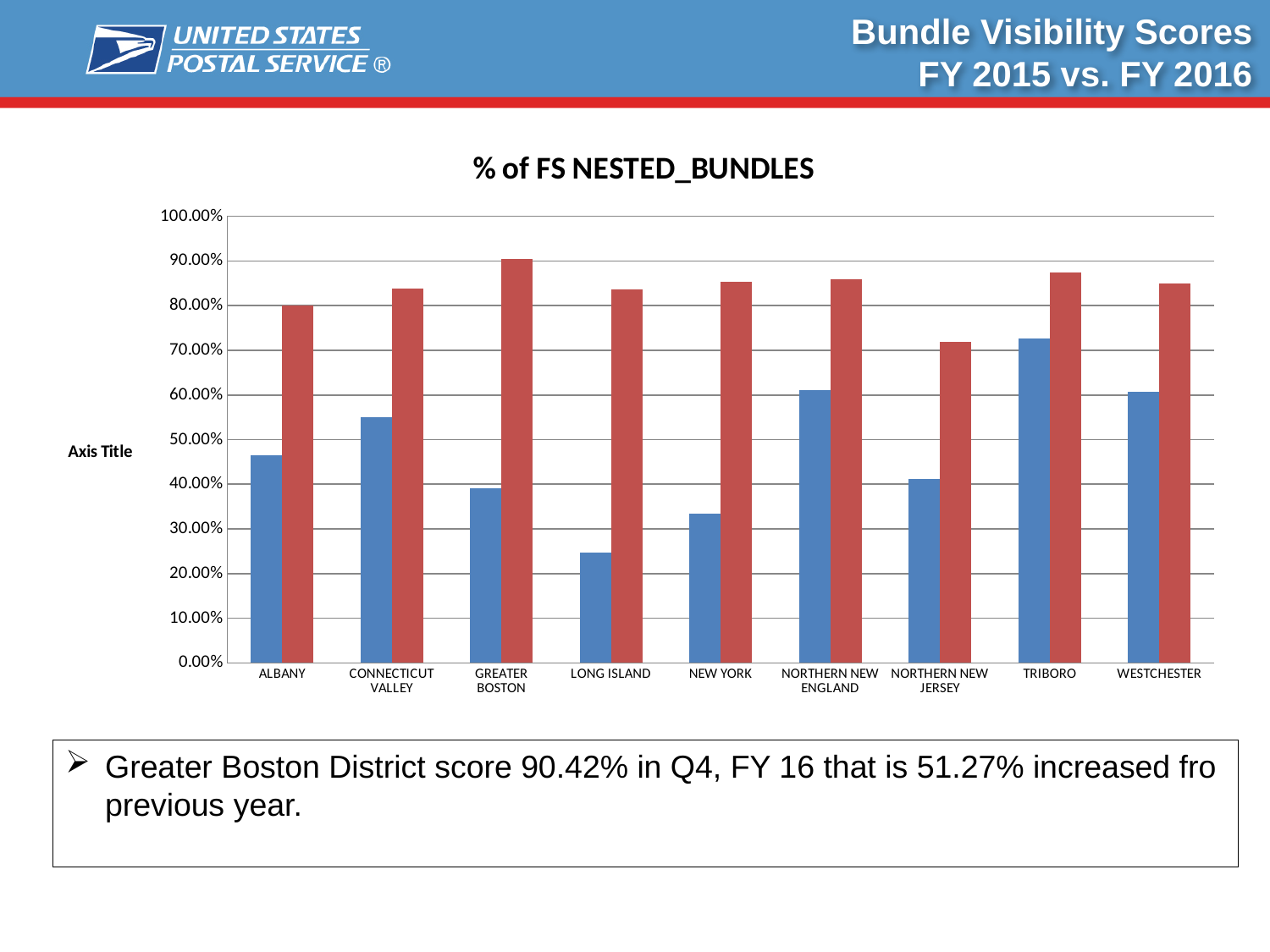
Is the blue bar for LONG ISLAND greater or less than 30.00%? less Which district has the tallest blue bar? TRIBORO Which district has the shortest blue bar? LONG ISLAND Which district has the tallest red bar? GREATER BOSTON How many districts are shown along the x axis of the chart? 9 What type of chart is shown on the slide? bar chart Is the blue bar for ALBANY greater or less than 50.00%? less Which is larger, the red bar for ALBANY or the red bar for NORTHERN NEW JERSEY? ALBANY What is the title of the chart? % of FS NESTED_BUNDLES Which is larger, the blue bar for ALBANY or the blue bar for CONNECTICUT VALLEY? CONNECTICUT VALLEY Is the red bar for NORTHERN NEW JERSEY greater or less than 80.00%? less Which district has the shortest red bar? NORTHERN NEW JERSEY